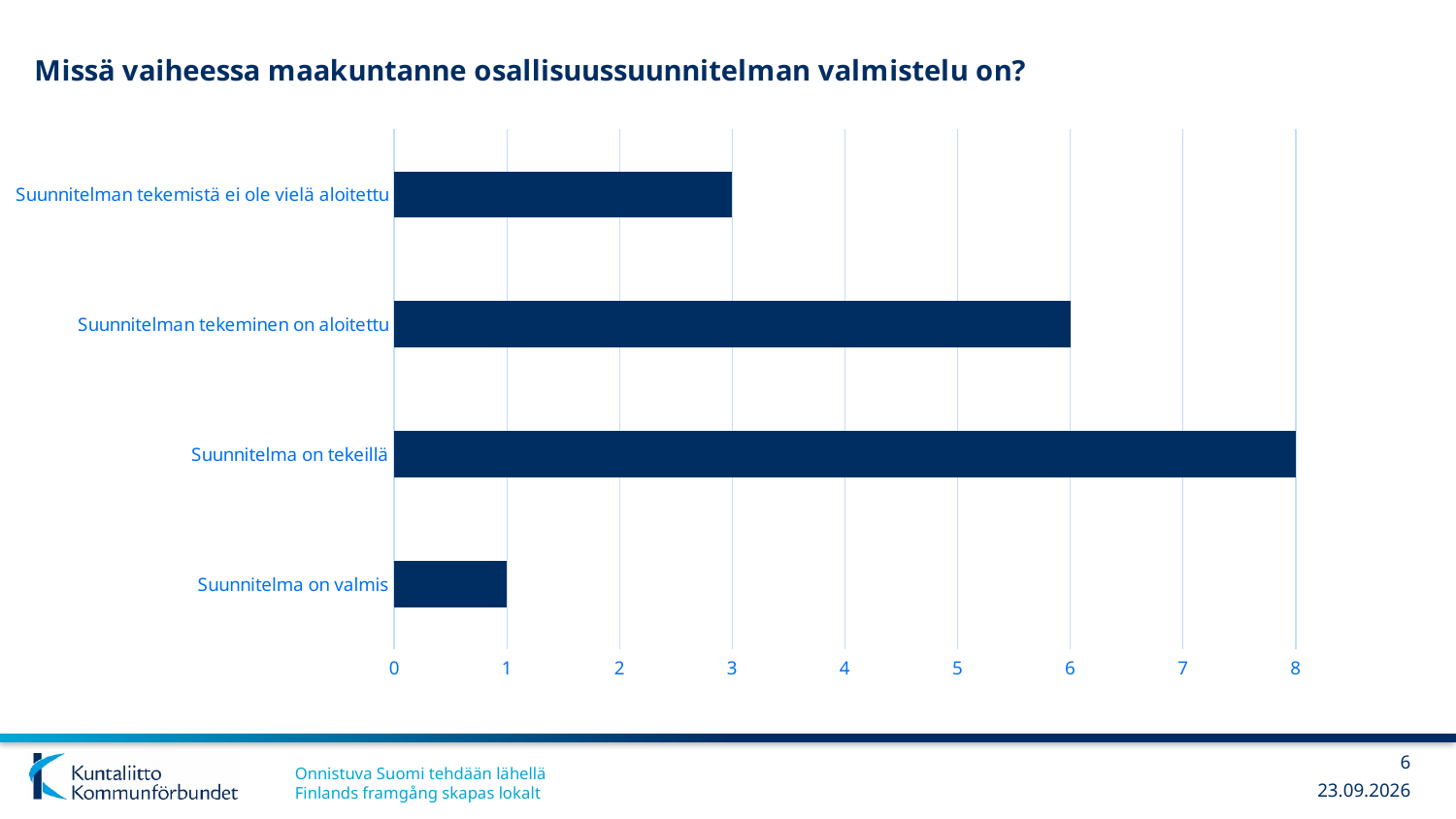
What is the value for "Suunnitelma on tekeillä"? 8 Is the value for "Suunnitelman tekeminen on aloitettu" greater or less than 4? greater Which category has the highest value? Suunnitelma on tekeillä What kind of chart is shown on the slide? Bar chart What is the value for "Suunnitelma on valmis"? 1 How many categories are shown in the chart? 4 What is the title of the chart? Missä vaiheessa maakuntanne osallisuussuunnitelman valmistelu on? What is the value for "Suunnitelman tekemistä ei ole vielä aloitettu"? 3 Which is larger: the value for "Suunnitelman tekemistä ei ole vielä aloitettu" or the value for "Suunnitelma on valmis"? Suunnitelman tekemistä ei ole vielä aloitettu What is the value for "Suunnitelman tekeminen on aloitettu"? 6 What is the difference between the values for "Suunnitelma on tekeillä" and "Suunnitelman tekeminen on aloitettu"? 2 Which category has the lowest value? Suunnitelma on valmis